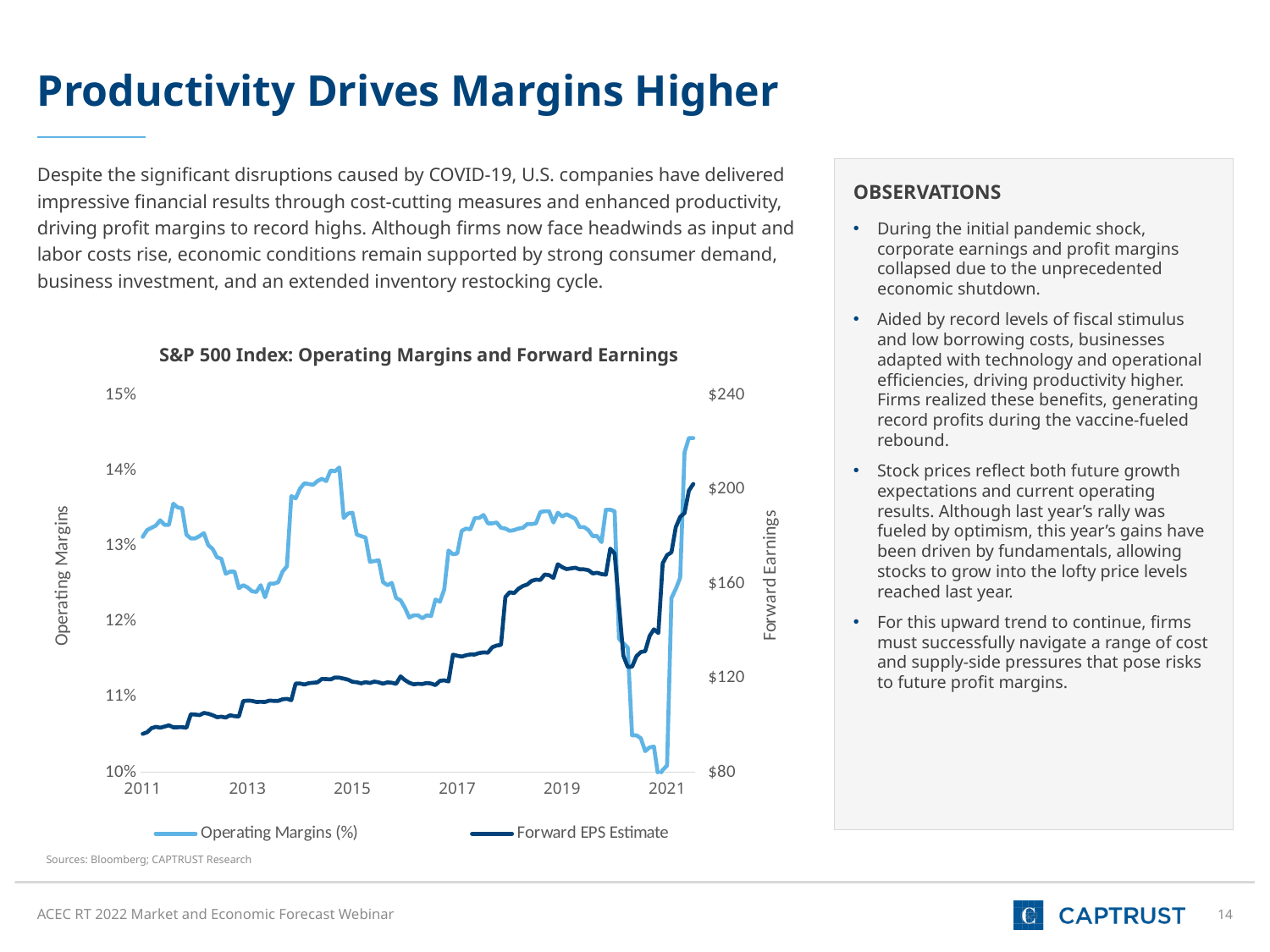
Does the Forward EPS Estimate generally rise or fall from 2011 to 2021? rise How many series does the chart legend list? 2 What is the title of the chart? S&P 500 Index: Operating Margins and Forward Earnings Do Operating Margins rise or fall between 2014 and 2016? fall What is the highest value shown on the right-hand Forward Earnings axis? $240 Is the Operating Margins value at the end of the series in 2021 greater or less than 14%? greater Is the Forward EPS Estimate at its 2020 low greater or less than $160? less Is the Forward EPS Estimate at the start of 2011 greater or less than $120? less How many year labels are shown on the x axis? 6 Which series is plotted in the lighter blue line? Operating Margins (%) What kind of chart is shown on the slide? line chart